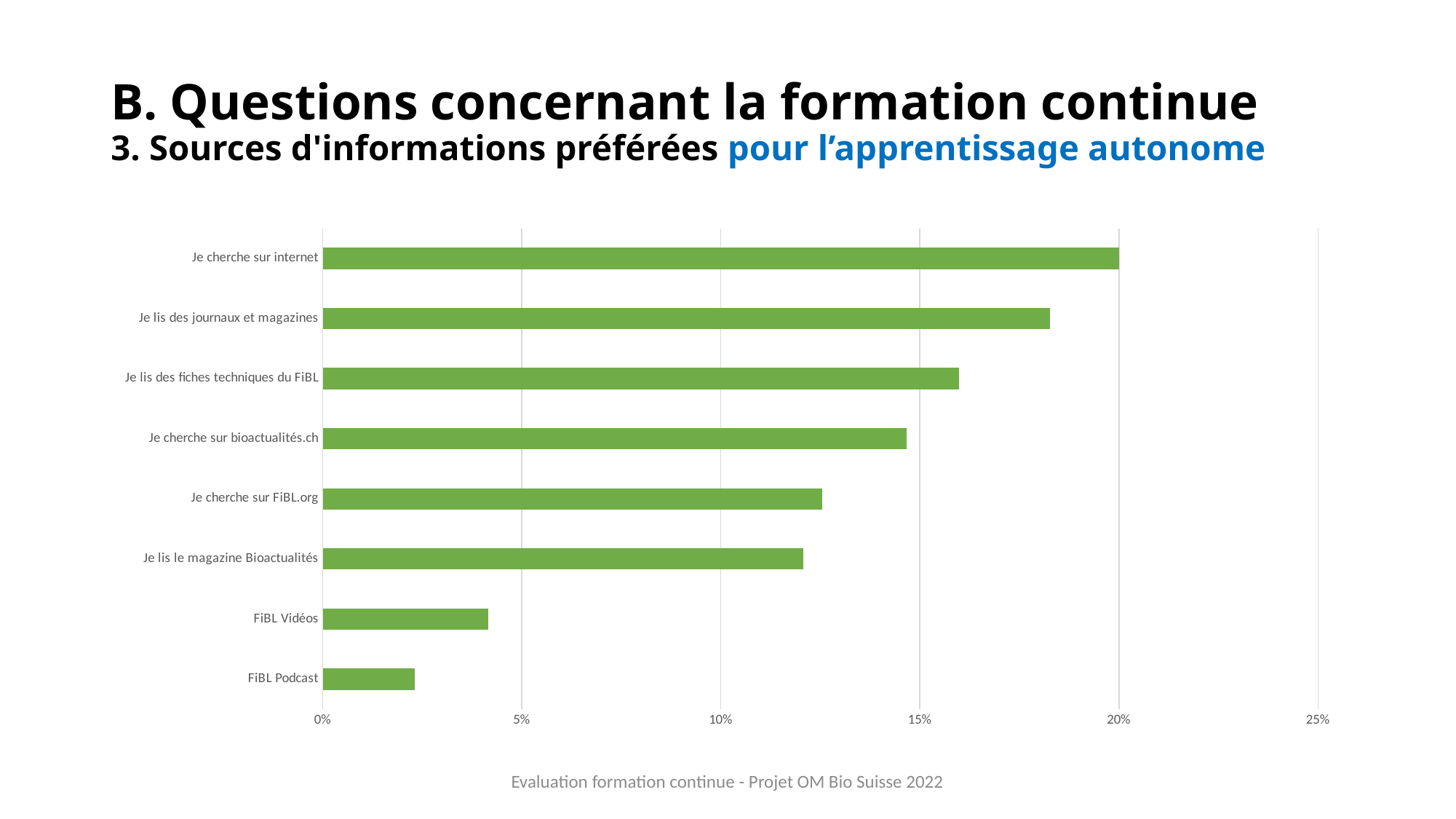
Is the value for "Je lis des journaux et magazines" greater or less than 15%? greater What kind of chart is shown on the slide? bar chart Which information source has the highest value in the chart? Je cherche sur internet Which has the larger value, "Je lis des journaux et magazines" or "Je lis des fiches techniques du FiBL"? Je lis des journaux et magazines Is the value for "FiBL Vidéos" greater or less than 5%? less How many categories (information sources) are plotted in the chart? 8 What is the value for "Je cherche sur internet"? 20% Which information source has the lowest value in the chart? FiBL Podcast Is the value for "Je lis des fiches techniques du FiBL" greater or less than 15%? greater What is the highest value shown on the horizontal axis of the chart? 25% Which has the larger value, "FiBL Vidéos" or "FiBL Podcast"? FiBL Vidéos